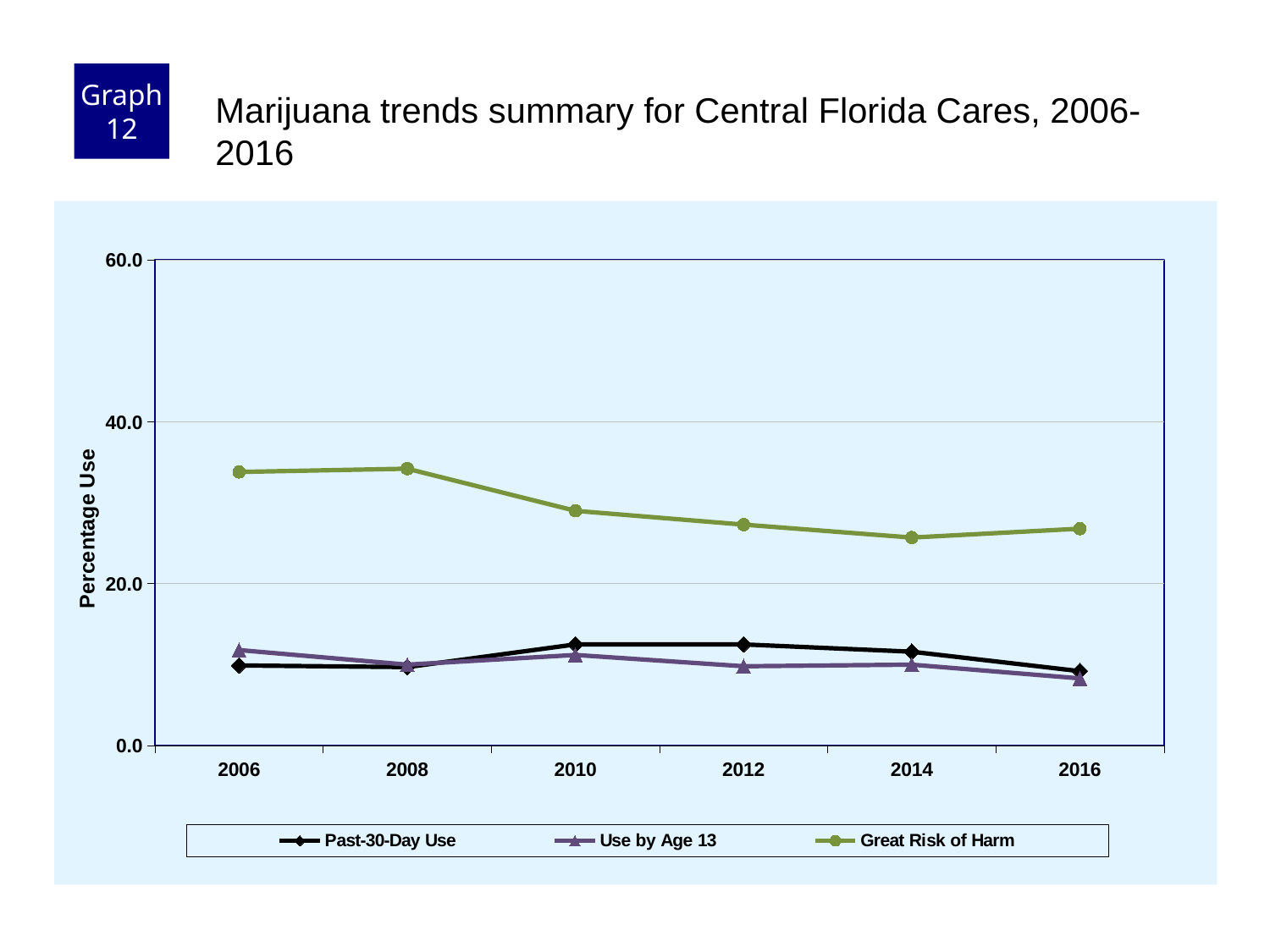
What is the label on the y axis? Percentage Use Is the value for Past-30-Day Use in 2012 greater or less than 20.0? less Is the value for Great Risk of Harm in 2014 greater or less than 20.0? greater What kind of chart is shown on the slide? line chart Does the Great Risk of Harm series rise or fall overall from 2006 to 2016? fall Is the value for Great Risk of Harm in 2006 greater or less than 40.0? less How many years are plotted along the x axis? 6 How many series does the legend list? 3 In 2016, which is larger: Past-30-Day Use or Use by Age 13? Past-30-Day Use Which series is drawn with a green line and circle markers? Great Risk of Harm Which series has the highest value in 2010? Great Risk of Harm In which year is the Use by Age 13 series at its lowest? 2016